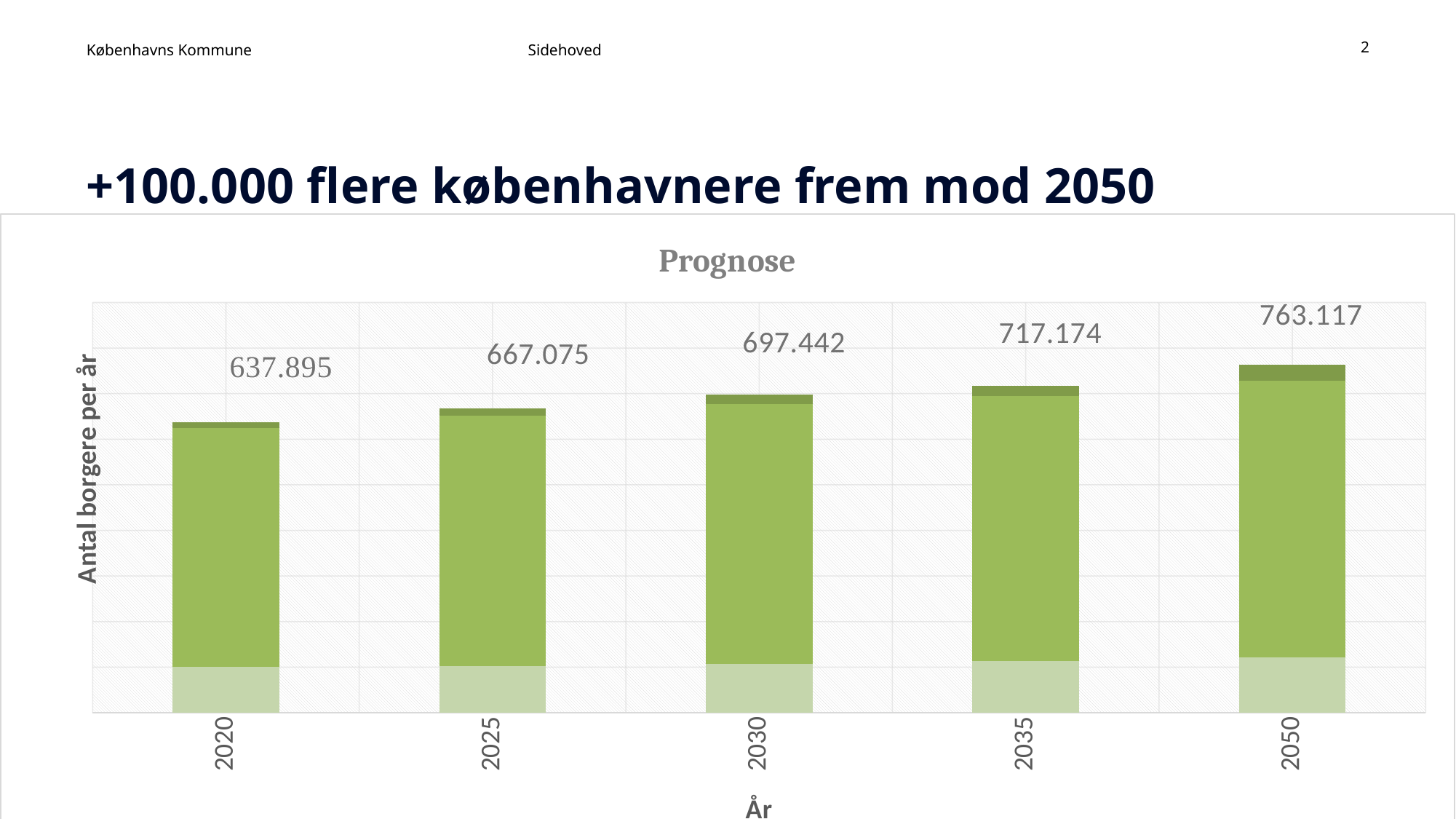
What is the value for 2020 in the Prognose chart? 637.895 What is the value for 2030 in the Prognose chart? 697.442 Do the values in the Prognose chart rise or fall from 2020 to 2050? rise What is the value for 2050 in the Prognose chart? 763.117 What is the difference between the values for 2050 and 2020 in the Prognose chart? 125.222 Which is larger in the Prognose chart, the value for 2030 or the value for 2025? 2030 What is the value for 2035 in the Prognose chart? 717.174 What is the difference between the values for 2025 and 2020 in the Prognose chart? 29.180 What kind of chart is the Prognose chart? bar chart Which year has the highest value in the Prognose chart? 2050 Which year has the lowest value in the Prognose chart? 2020 How many years are shown on the x axis of the Prognose chart? 5